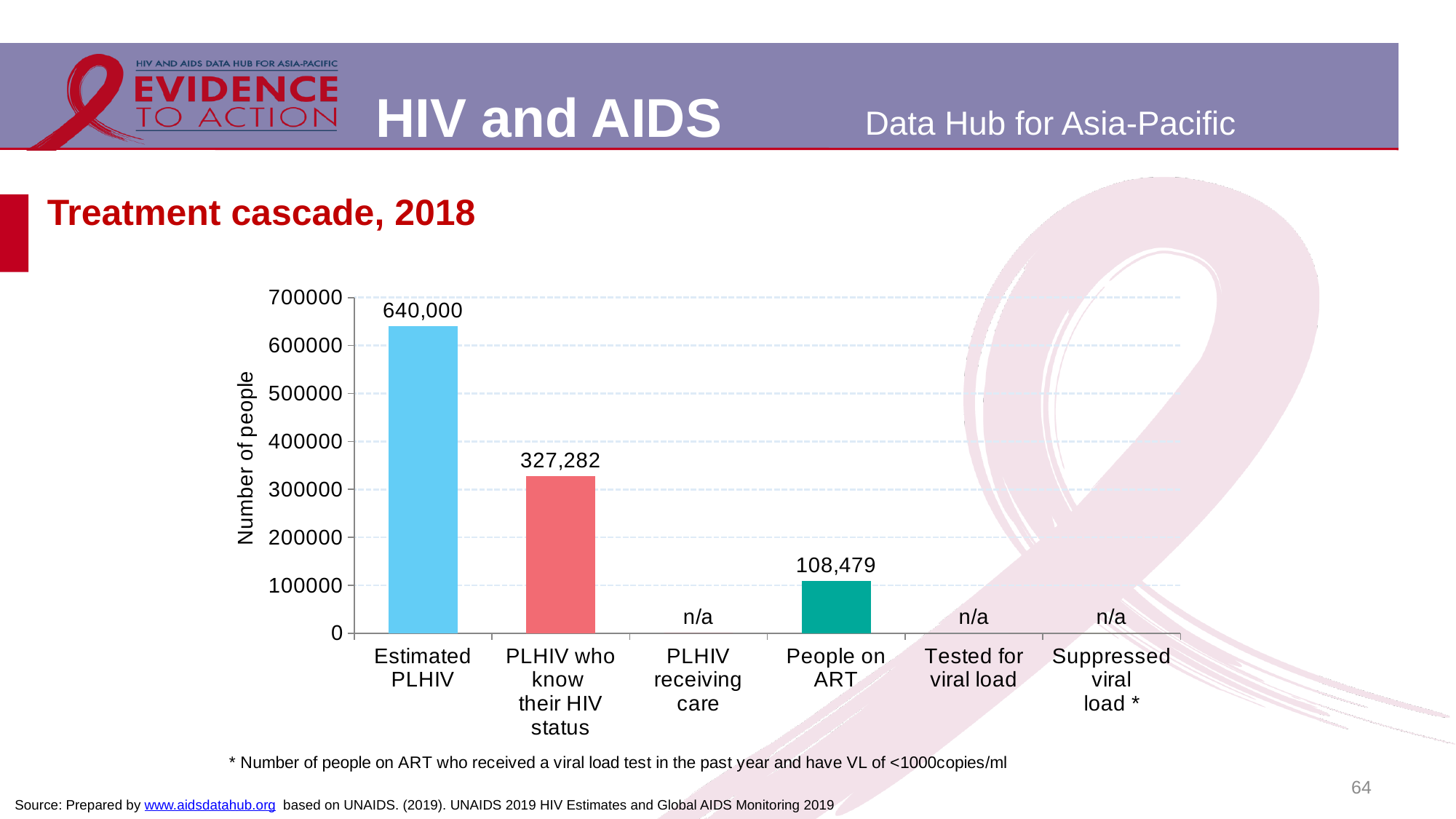
What is the difference between Estimated PLHIV and PLHIV who know their HIV status? 312,718 Which category has the highest value? Estimated PLHIV What is the title of the chart? Treatment cascade, 2018 What is the value for Estimated PLHIV? 640,000 What is the difference between PLHIV who know their HIV status and People on ART? 218,803 What kind of chart is this? Bar chart What is the value for PLHIV who know their HIV status? 327,282 What is the value for People on ART? 108,479 What is shown for PLHIV receiving care? n/a How many categories are shown on the x axis? 6 Among the categories with a numeric value, which has the lowest value? People on ART Which is larger, PLHIV who know their HIV status or People on ART? PLHIV who know their HIV status